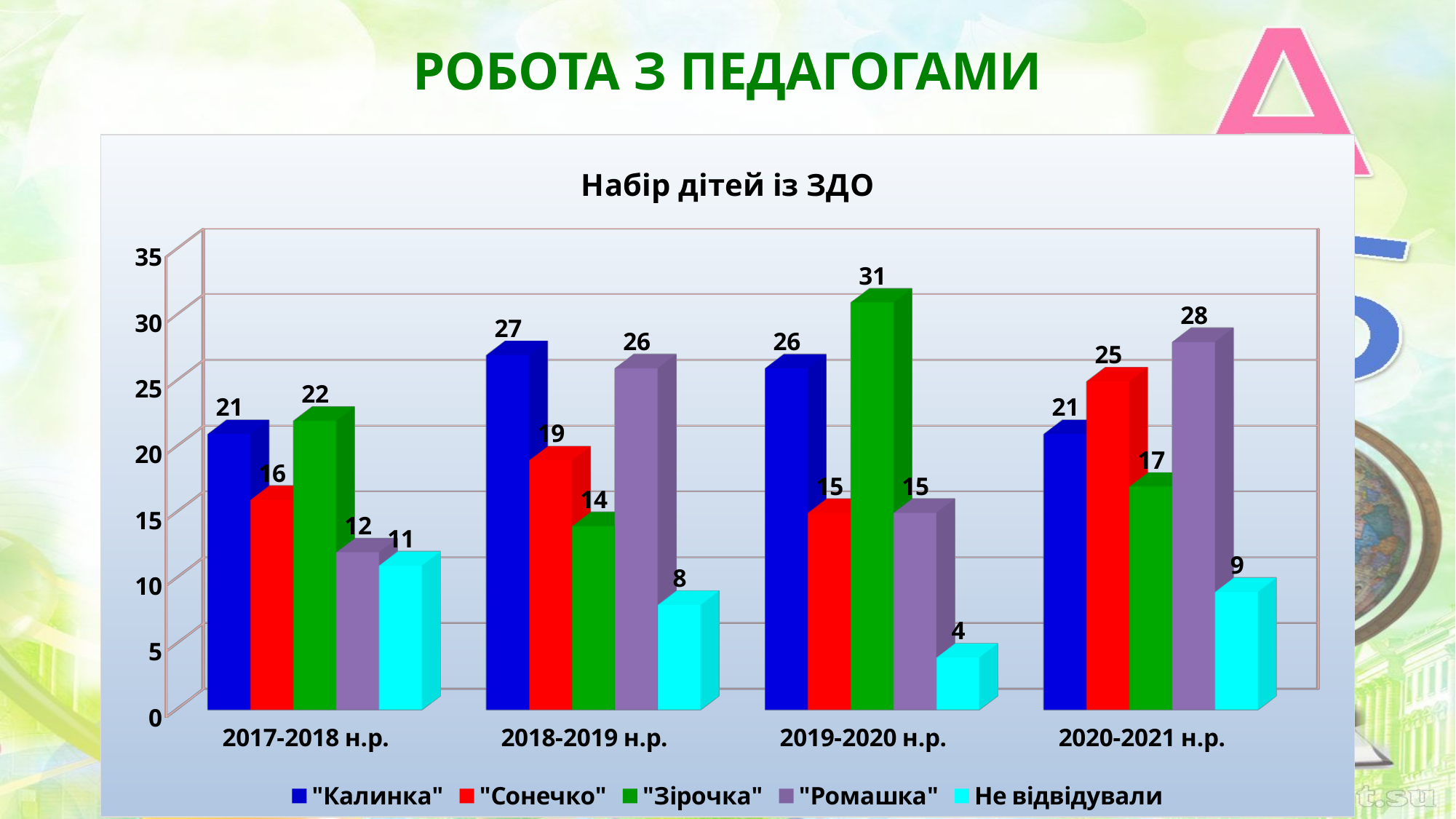
In which school year is the value for "Не відвідували" lowest? 2019-2020 н.р. What is the value for "Не відвідували" in 2018-2019 н.р.? 8 How many school years are shown on the x axis? 4 In which school year is the value for "Ромашка" highest? 2020-2021 н.р. What kind of chart is shown on the slide? Bar chart How many series does the legend list? 5 What is the title of the chart? Набір дітей із ЗДО What is the difference between the "Калинка" value in 2018-2019 н.р. and in 2017-2018 н.р.? 6 Does the value for "Не відвідували" rise or fall from 2017-2018 н.р. to 2019-2020 н.р.? Fall What is the value for "Сонечко" in 2020-2021 н.р.? 25 Which is larger in 2020-2021 н.р.: the value for "Калинка" or for "Сонечко"? "Сонечко" What is the value for "Зірочка" in 2019-2020 н.р.? 31